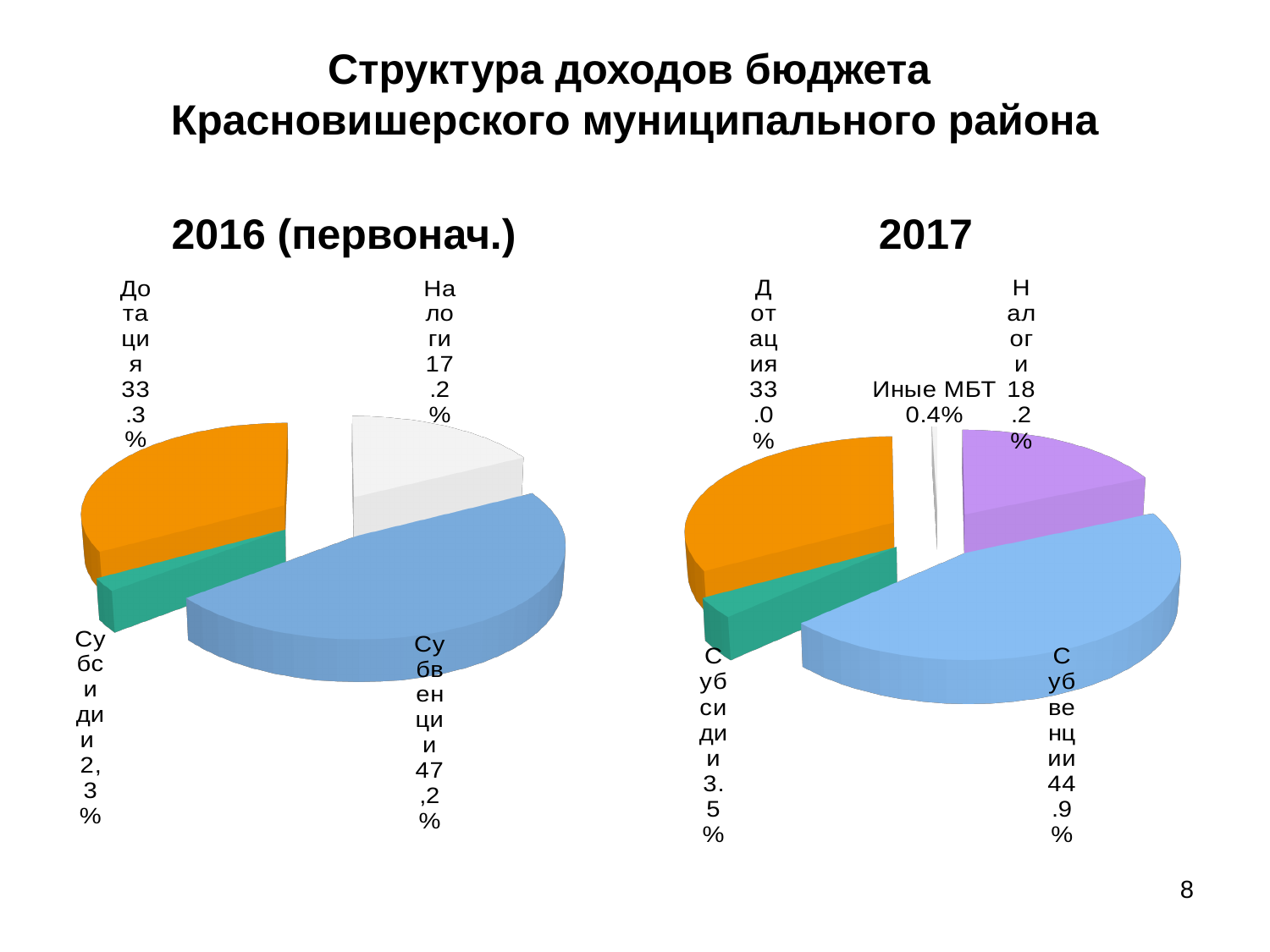
In the 2016 (первонач.) chart, which category has the smallest share? Субсидии In the 2016 (первонач.) chart, what share do Налоги have? 17.2% In the 2017 chart, which is larger: Дотация or Налоги? Дотация In the 2016 (первонач.) chart, what share do Субвенции have? 47,2% In the 2017 chart, which category has the smallest share? Иные МБТ In the 2017 chart, what share does Дотация have? 33.0% In the 2017 chart, what is the difference between the shares of Субвенции and Дотация? 11.9% What kind of chart is the 2017 chart? Pie chart In the 2017 chart, which category has the largest share? Субвенции How many categories are shown in the 2017 chart? 5 How many categories are shown in the 2016 (первонач.) chart? 4 In the 2017 chart, what share do Иные МБТ have? 0.4%